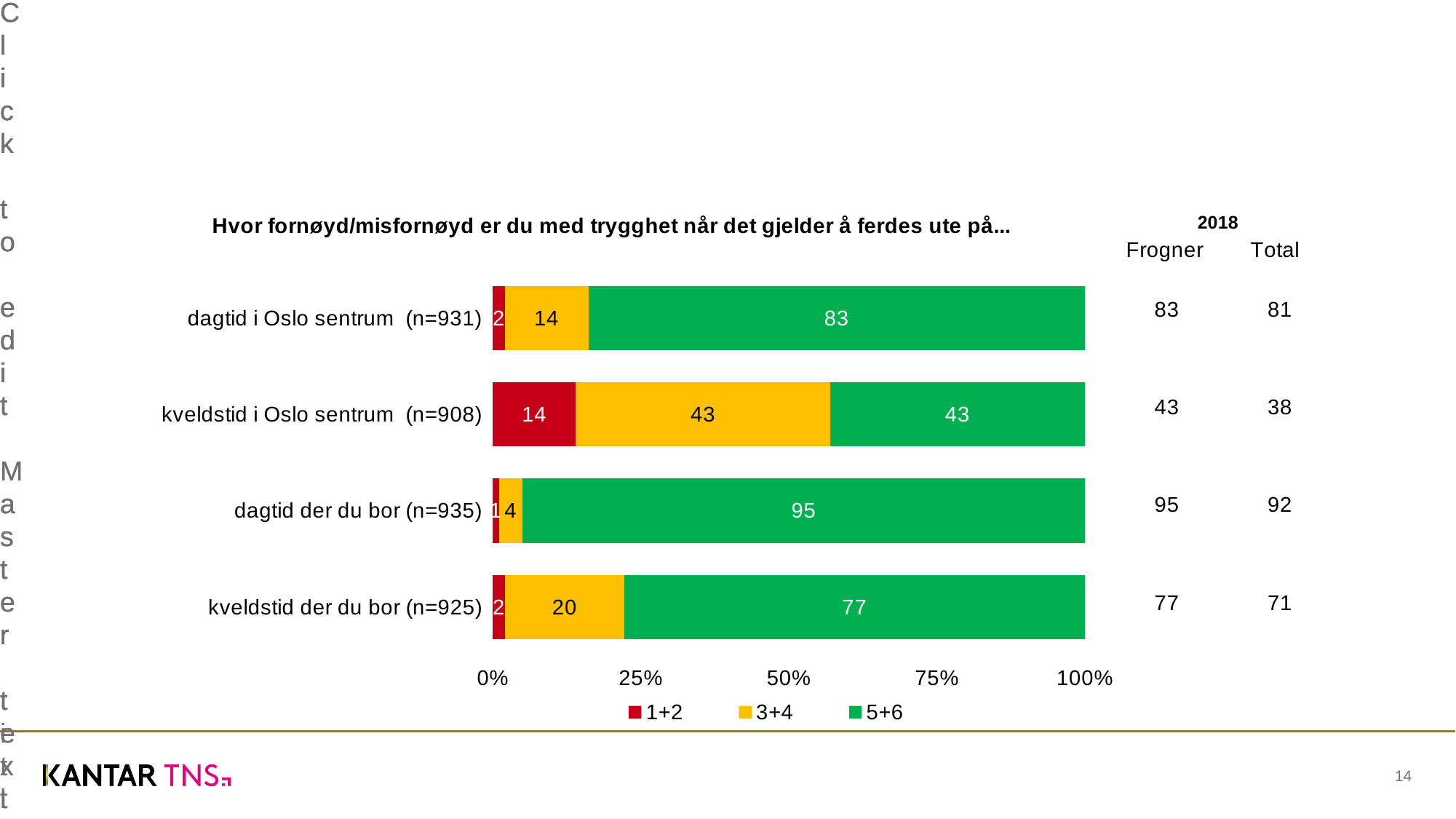
What is the value of the 1+2 segment for "kveldstid i Oslo sentrum (n=908)"? 14 How many series does the legend list? 3 What is the value of the 3+4 segment for "kveldstid der du bor (n=925)"? 20 Which colour represents the 5+6 series in the legend? green Is the 5+6 value for "kveldstid i Oslo sentrum (n=908)" greater or less than 50%? less What type of chart is shown on the slide? stacked bar chart What is the difference between the 5+6 values for "dagtid der du bor (n=935)" and "kveldstid der du bor (n=925)"? 18 Which is larger: the 3+4 value for "kveldstid i Oslo sentrum (n=908)" or the 3+4 value for "dagtid i Oslo sentrum (n=931)"? kveldstid i Oslo sentrum (n=908) Which category has the highest 5+6 value? dagtid der du bor (n=935) How many categories are plotted in the chart? 4 Which category has the lowest 5+6 value? kveldstid i Oslo sentrum (n=908) What is the value of the 5+6 segment for "dagtid i Oslo sentrum (n=931)"? 83